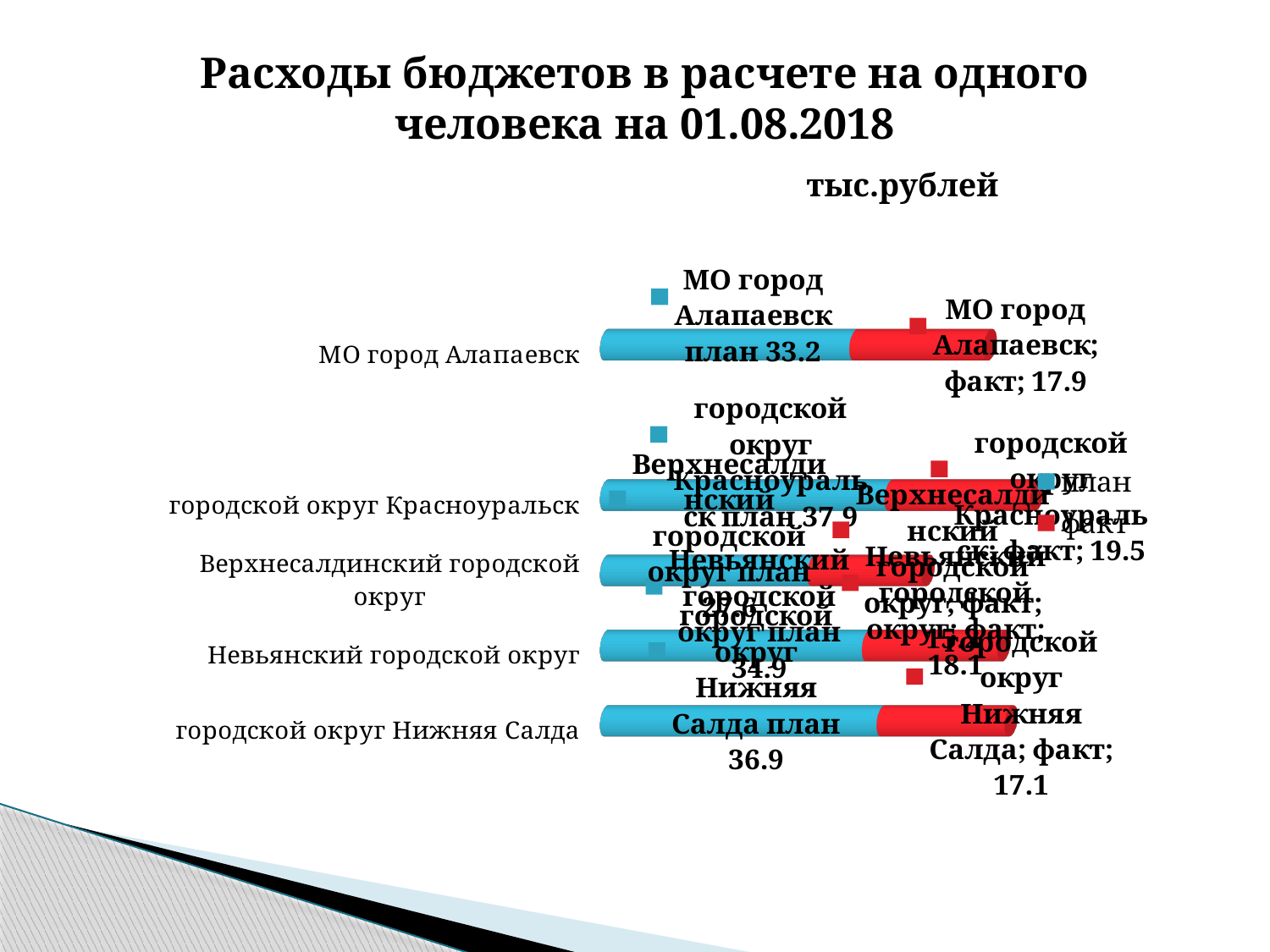
What is the факт value for городской округ Красноуральск? 19.5 What is the план (plan) value for МО город Алапаевск? 33.2 What kind of chart is shown on the slide? bar chart How many series does the chart's legend list? 2 Which has the larger план value: городской округ Красноуральск or городской округ Нижняя Салда? городской округ Красноуральск What is the difference between the план and факт values for МО город Алапаевск? 15.3 How many municipalities (categories) are shown on the chart? 5 What is the факт value for городской округ Нижняя Салда? 17.1 In what units are the values on the chart expressed, according to the slide? тыс.рублей What is the план value for городской округ Нижняя Салда? 36.9 What is the факт (actual) value for МО город Алапаевск? 17.9 What is the план value for городской округ Красноуральск? 37.9